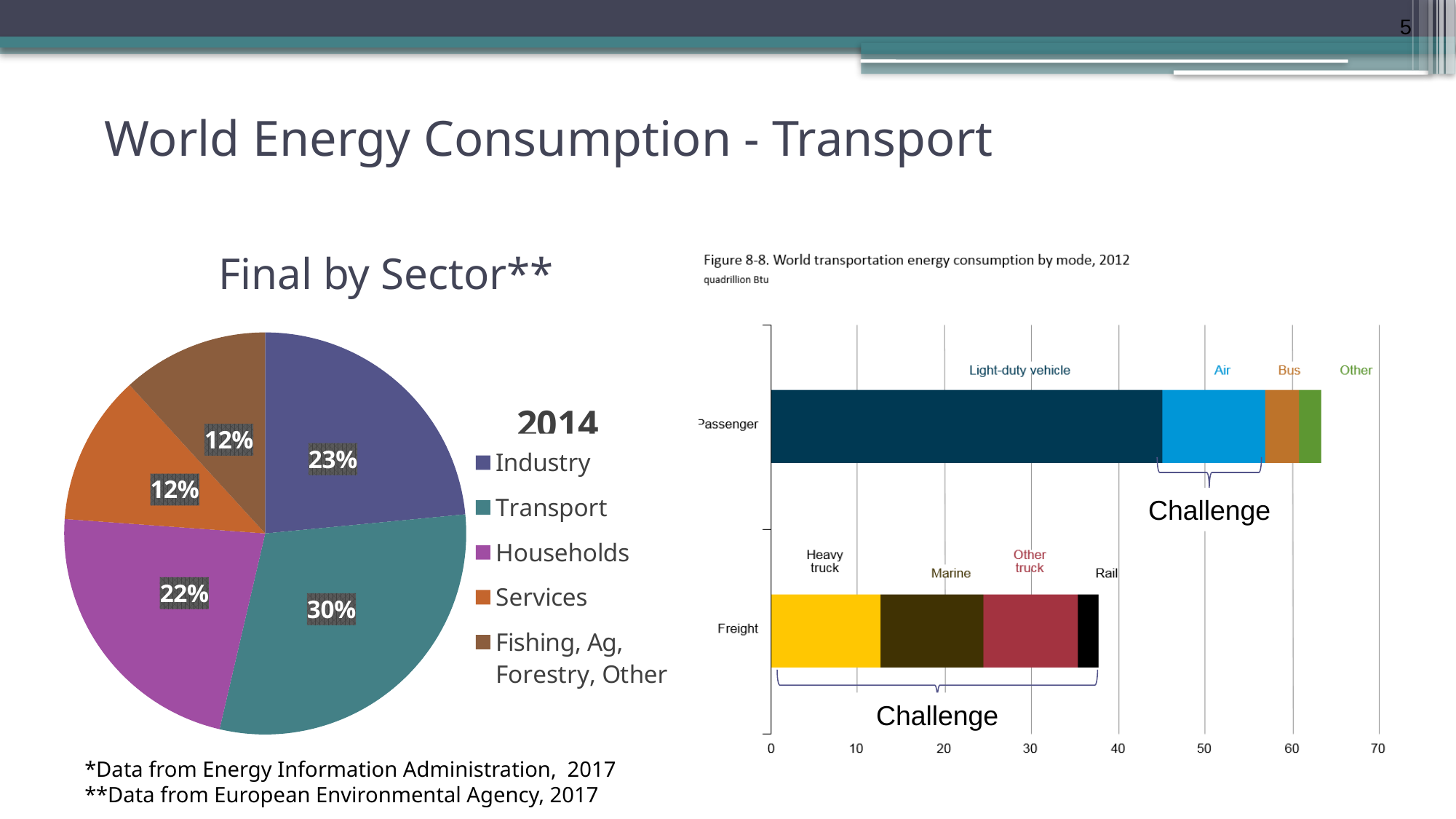
In the 'Figure 8-8' chart, is the total value for Freight greater or less than 40? less In the 'Final by Sector**' pie chart, what share does Households have? 22% What type of chart is 'Final by Sector**'? Pie chart In the 'Final by Sector**' pie chart, what share does Industry have? 23% In the 'Final by Sector**' pie chart, what share does Transport have? 30% What type of chart is 'Figure 8-8. World transportation energy consumption by mode, 2012'? Bar chart How many sectors are shown in the 'Final by Sector**' pie chart? 5 In the 'Final by Sector**' pie chart, which sector has the largest share? Transport What year is shown in the legend of the 'Final by Sector**' pie chart? 2014 In the 'Figure 8-8' chart, is the total value for Passenger greater or less than 60? greater In the 'Final by Sector**' pie chart, which is larger, Industry or Households? Industry In the 'Final by Sector**' pie chart, what is the difference between the Transport share and the Industry share? 7%